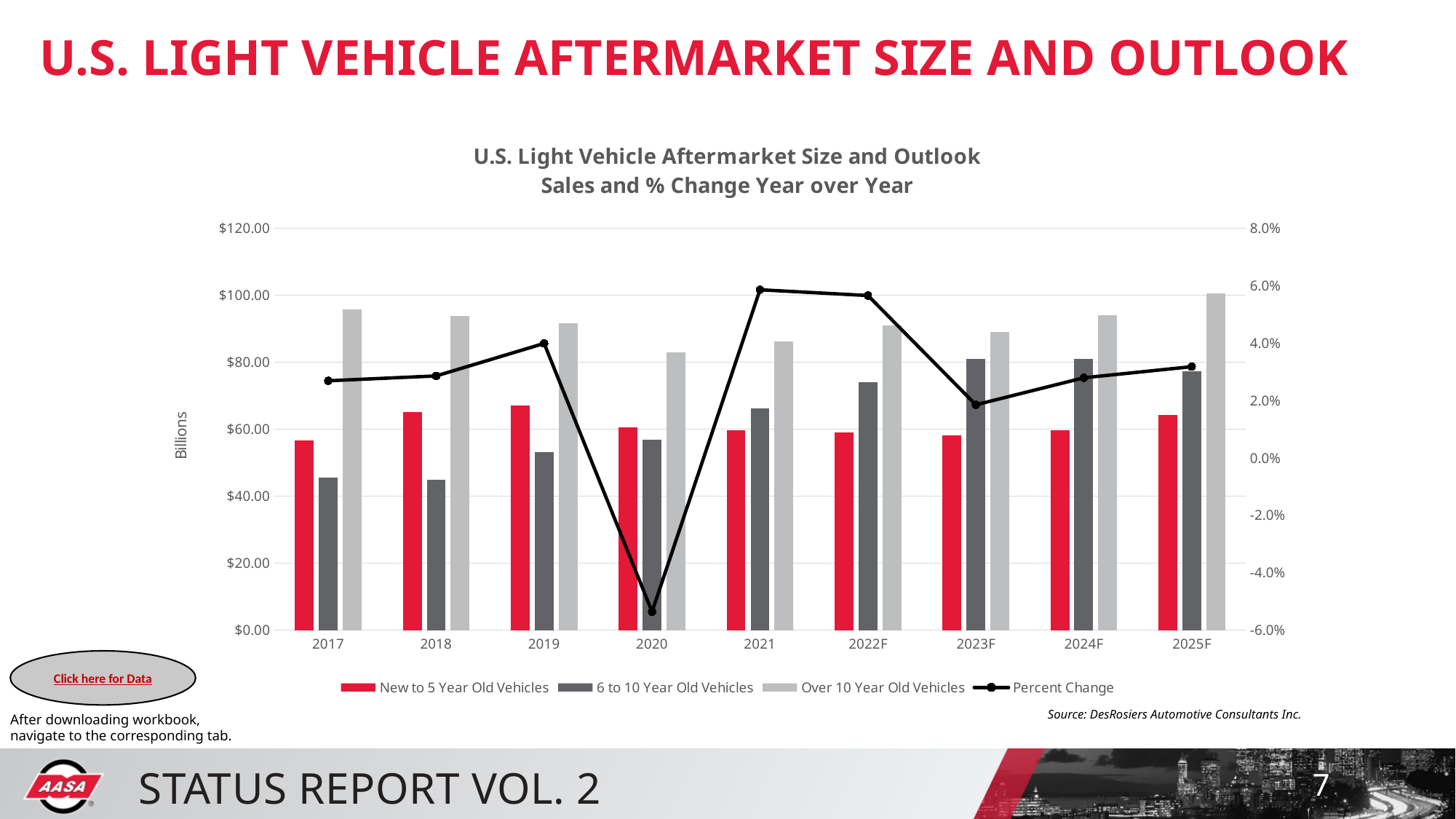
Is the value for 6 to 10 Year Old Vehicles in 2017 greater or less than $60.00? less In which year is the Percent Change line at its highest point? 2021 What kind of chart is shown on the slide? A bar chart combined with a line Is the Percent Change value for 2020 greater or less than 0.0%? less Is the value for Over 10 Year Old Vehicles in 2017 greater or less than $80.00? greater Do the values for 6 to 10 Year Old Vehicles generally rise or fall from 2017 to 2023F? rise In 2023F, which is larger: New to 5 Year Old Vehicles or 6 to 10 Year Old Vehicles? 6 to 10 Year Old Vehicles In which year is the Percent Change line at its lowest point? 2020 How many series does the chart legend list? 4 What colour are the bars for New to 5 Year Old Vehicles? Red In 2019, which is larger: New to 5 Year Old Vehicles or 6 to 10 Year Old Vehicles? New to 5 Year Old Vehicles How many years are shown along the x axis of the chart? 9